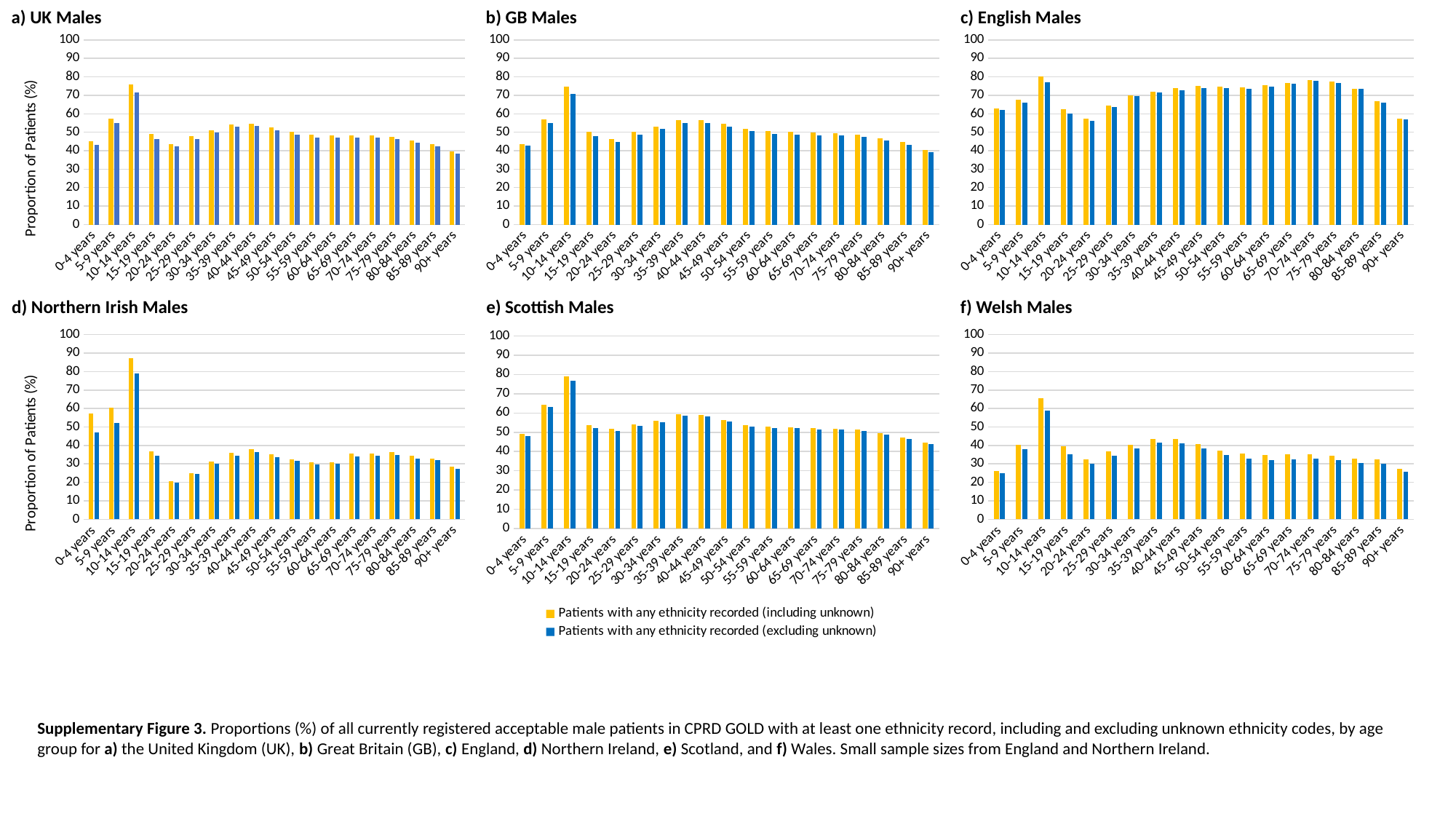
How many series does the legend list? 2 In the 'a) UK Males' chart, how many age groups are shown on the x axis? 19 How many charts are on the slide? 6 In the 'e) Scottish Males' chart, is the value for 10-14 years (including unknown) greater or less than 70? greater In the 'd) Northern Irish Males' chart, which age group has the lowest proportion of patients with any ethnicity recorded (including unknown)? 20-24 years What kind of chart is 'd) Northern Irish Males'? bar chart In the 'd) Northern Irish Males' chart, is the value for 10-14 years (including unknown) greater or less than 80? greater In the 'd) Northern Irish Males' chart, which age group has the highest proportion of patients with any ethnicity recorded (including unknown)? 10-14 years In the 'd) Northern Irish Males' chart, which is larger for patients with any ethnicity recorded (including unknown): 0-4 years or 20-24 years? 0-4 years In the 'b) GB Males' chart, do the values generally rise or fall from 40-44 years to 90+ years? fall What is the y-axis label on the 'a) UK Males' chart? Proportion of Patients (%) In the 'f) Welsh Males' chart, is the value for 10-14 years (including unknown) greater or less than 60? greater